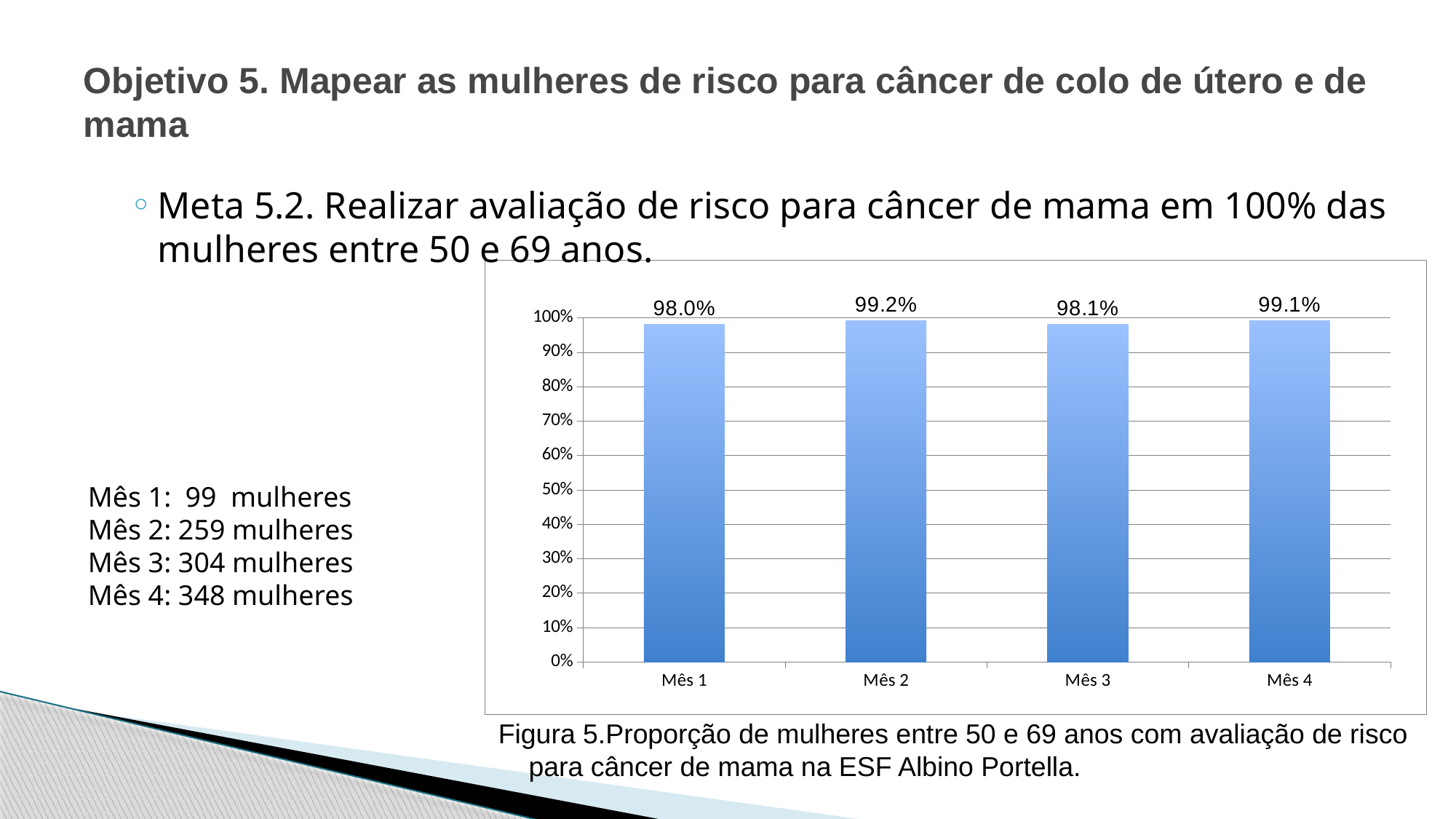
Is the value for Mês 1 greater or less than 90%? greater What is the value for Mês 2? 99.2% What is the value for Mês 1? 98.0% Which is larger, the value for Mês 3 or the value for Mês 4? Mês 4 What kind of chart is shown? bar chart Which month has the lowest value? Mês 1 What is the difference between the values for Mês 2 and Mês 1? 1.2% How many months are shown on the x axis? 4 Which month has the highest value? Mês 2 What is the highest tick value shown on the y axis? 100% What is the value for Mês 4? 99.1% What is the value for Mês 3? 98.1%